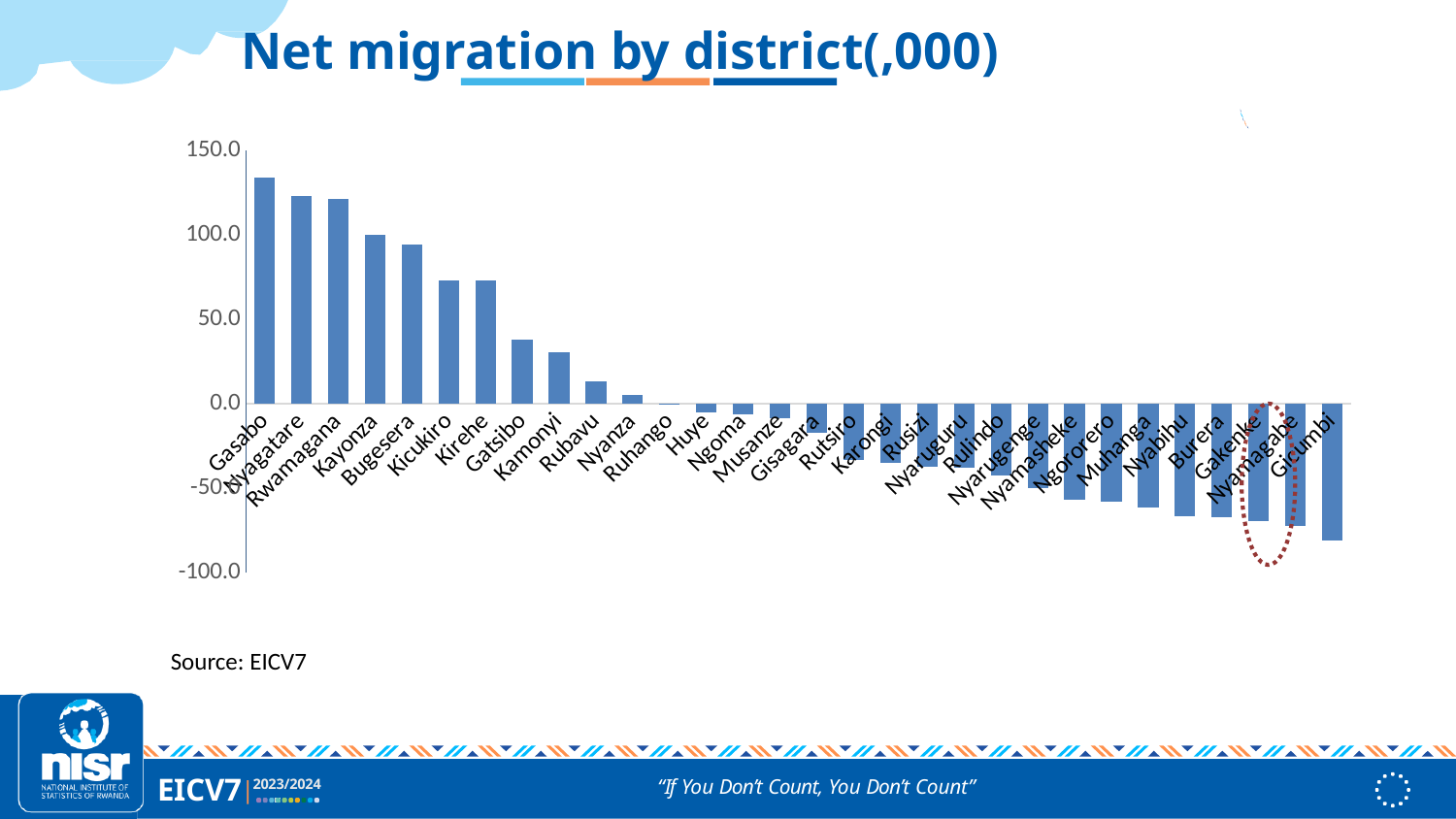
What source is cited below the chart? EICV7 What is the title of the chart? Net migration by district(,000) Is the value for Kicukiro greater or less than 50.0? greater Which has the larger net migration, Gasabo or Kayonza? Gasabo What kind of chart is shown on the slide? bar chart How many districts are shown on the x axis of the chart? 30 Is the value for Gatsibo greater or less than 50.0? less Which district has the highest net migration? Gasabo Is the value for Gicumbi greater or less than -50.0? less Which district has the lowest net migration? Gicumbi Do the values rise or fall moving from left to right along the x axis? fall